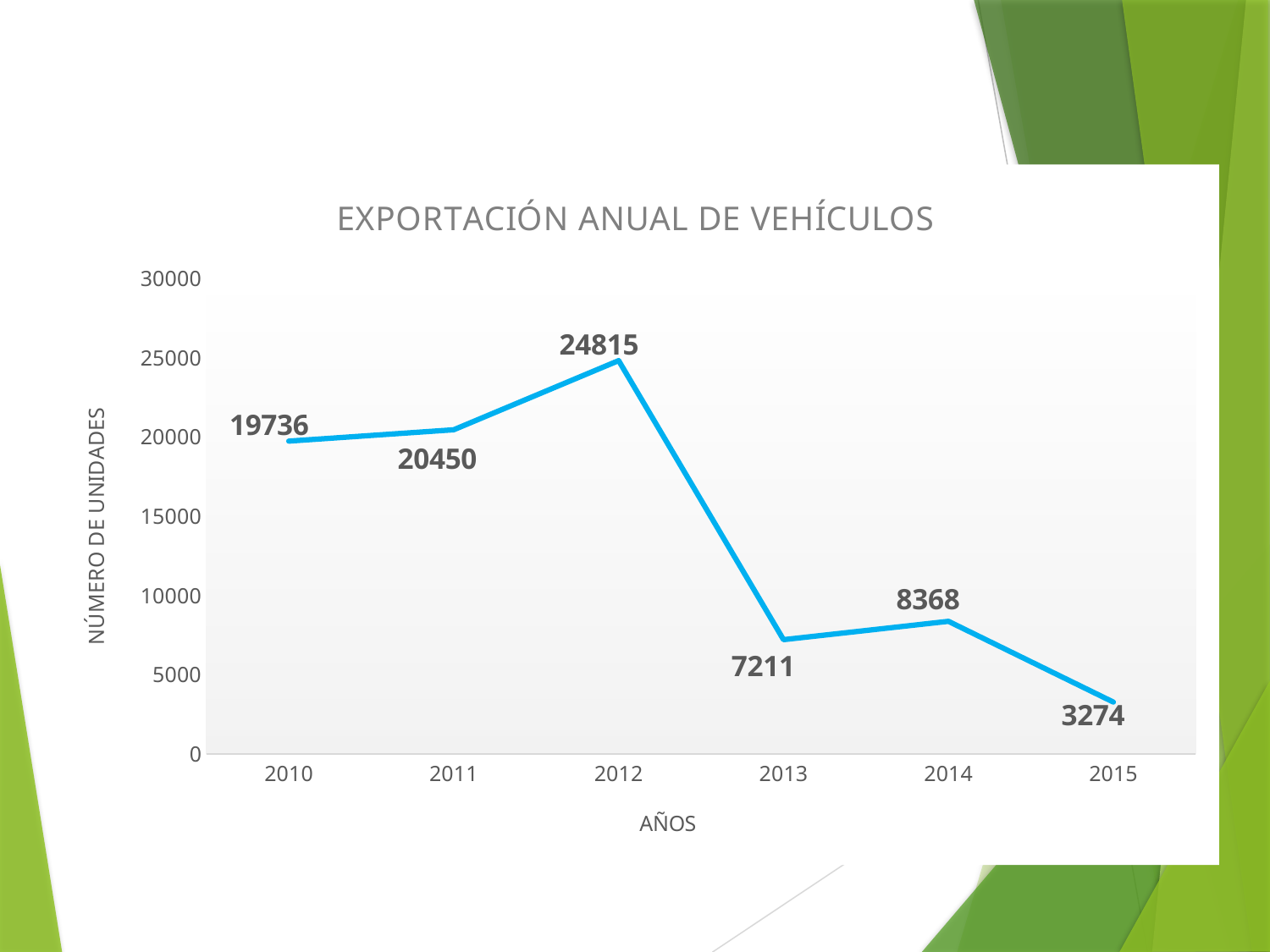
Which year has the lowest value? 2015 What is the difference between the values for 2012 and 2013? 17604 What is the value for 2010? 19736 How many years are plotted on the chart? 6 What is the value for 2015? 3274 What is the difference between the values for 2011 and 2010? 714 Is the value for 2014 greater or less than 10000? less Which year has the highest value? 2012 What is the value for 2012? 24815 What is the title of the chart? EXPORTACIÓN ANUAL DE VEHÍCULOS Which is larger, the value for 2013 or the value for 2014? 2014 What kind of chart is shown? line chart